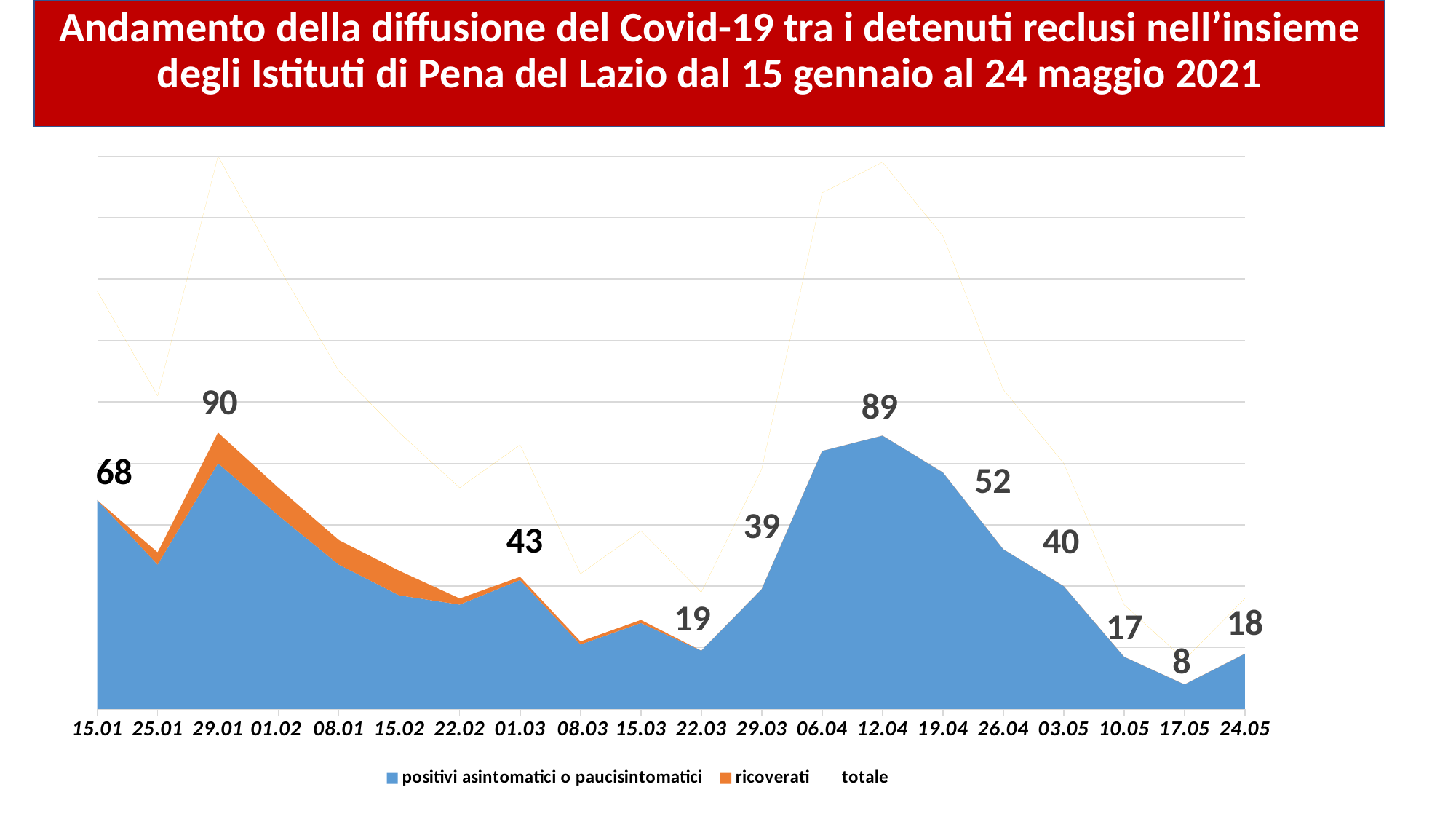
Which is larger, the labelled value for 15.01 or for 01.03? 15.01 What kind of chart is shown on the slide? Area chart What value is labelled for 12.04? 89 Which date has the lowest labelled value? 17.05 What is the difference between the labelled values for 12.04 and 26.04? 37 What value is labelled for 29.01? 90 How many dates are shown on the x axis? 20 What value is labelled for 24.05? 18 Which date has the highest labelled value? 29.01 What value is labelled for 17.05? 8 How many series does the legend list? 3 What is the difference between the labelled values for 29.01 and 15.01? 22